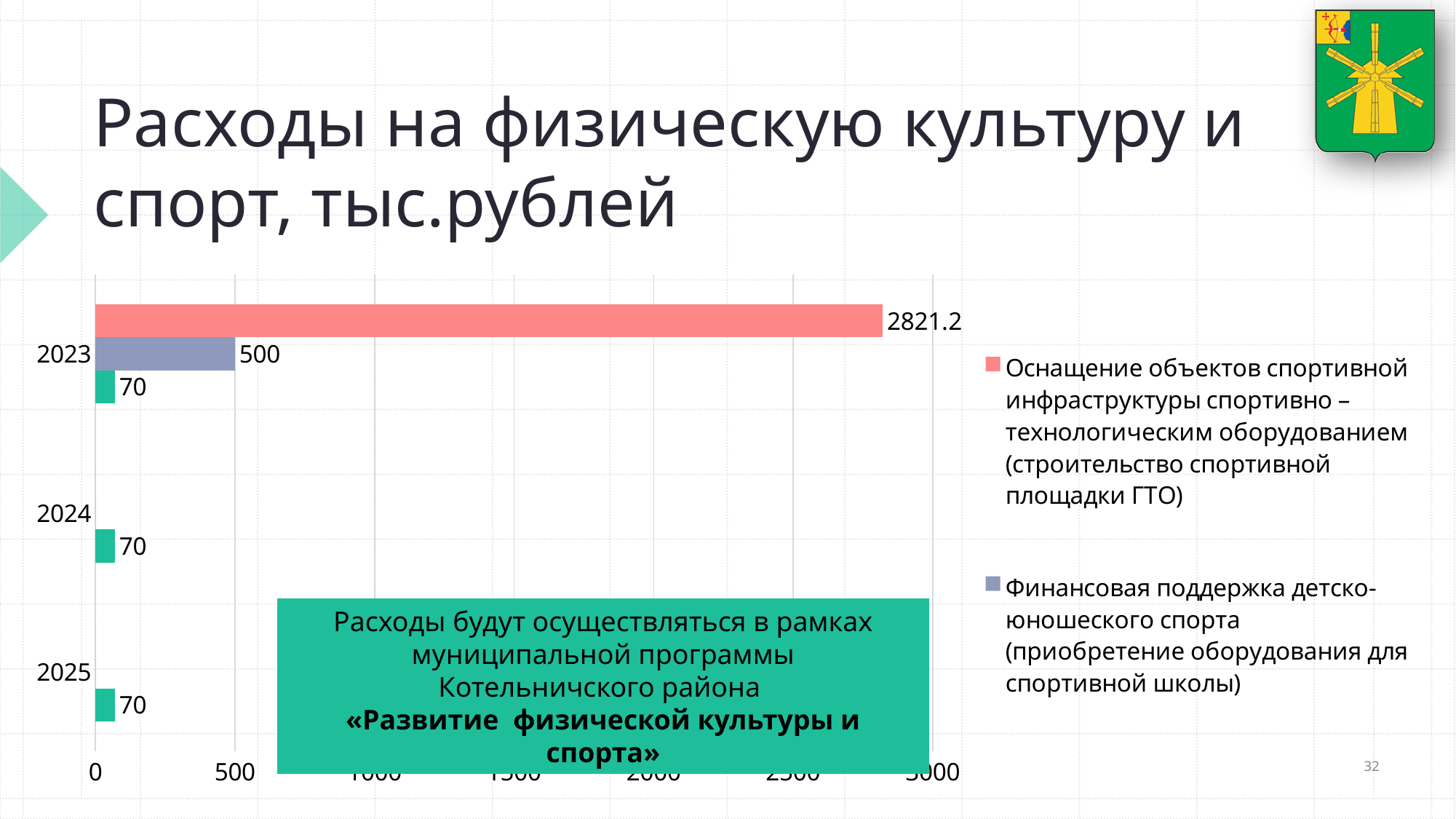
Which year has the largest single bar in the chart? 2023 What colour represents «Оснащение объектов спортивной инфраструктуры» in the legend? red What type of chart is shown on the slide? bar chart What is the difference between the 2023 values for «Оснащение объектов спортивной инфраструктуры» and «Финансовая поддержка детско-юношеского спорта»? 2321.2 Do the values of the green bars rise, fall or stay the same from 2023 to 2025? stay the same How many years are shown on the chart's vertical axis? 3 What is the total of all bars for 2023? 3391.2 What is the value of the green bar for 2024? 70 In 2023, which is larger: «Оснащение объектов спортивной инфраструктуры» or «Финансовая поддержка детско-юношеского спорта»? Оснащение объектов спортивной инфраструктуры What is the value for «Финансовая поддержка детско-юношеского спорта» in 2023? 500 What is the value for «Оснащение объектов спортивной инфраструктуры спортивно-технологическим оборудованием» in 2023? 2821.2 What is the value of the green bar for 2025? 70